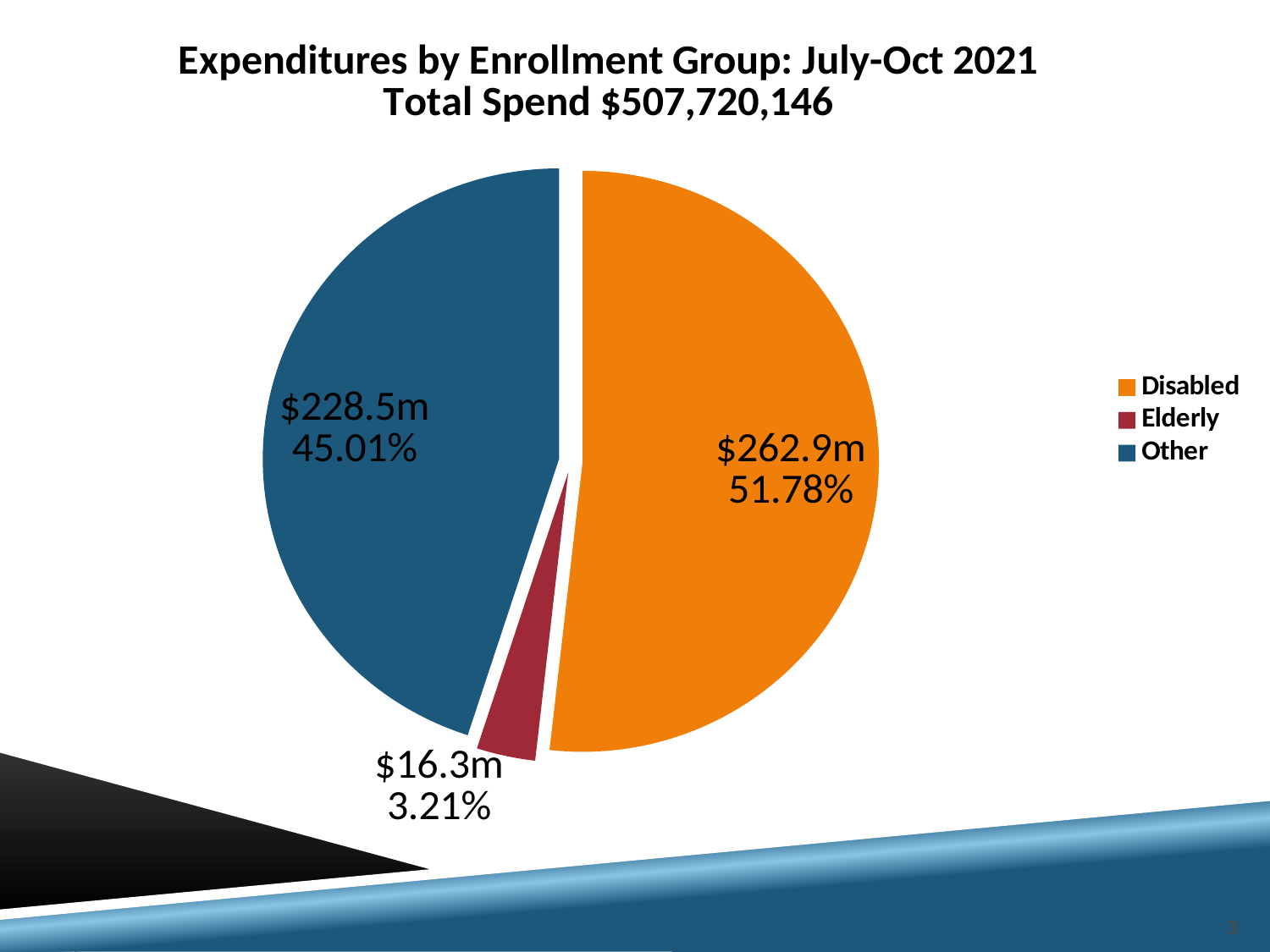
What type of chart is shown on the slide? pie chart What is the expenditure value for the Other enrollment group? $228.5m What is the expenditure value for the Disabled enrollment group? $262.9m Which enrollment group has the largest expenditure? Disabled Which group has a larger expenditure, Disabled or Other? Disabled What share of total spend does the Elderly group account for? 3.21% What is the total spend stated in the chart title? $507,720,146 What share of total spend does the Other group account for? 45.01% Which colour represents the Elderly group in the legend? dark red Which enrollment group has the smallest expenditure? Elderly How many enrollment groups are shown in the pie chart? 3 What is the expenditure value for the Elderly enrollment group? $16.3m